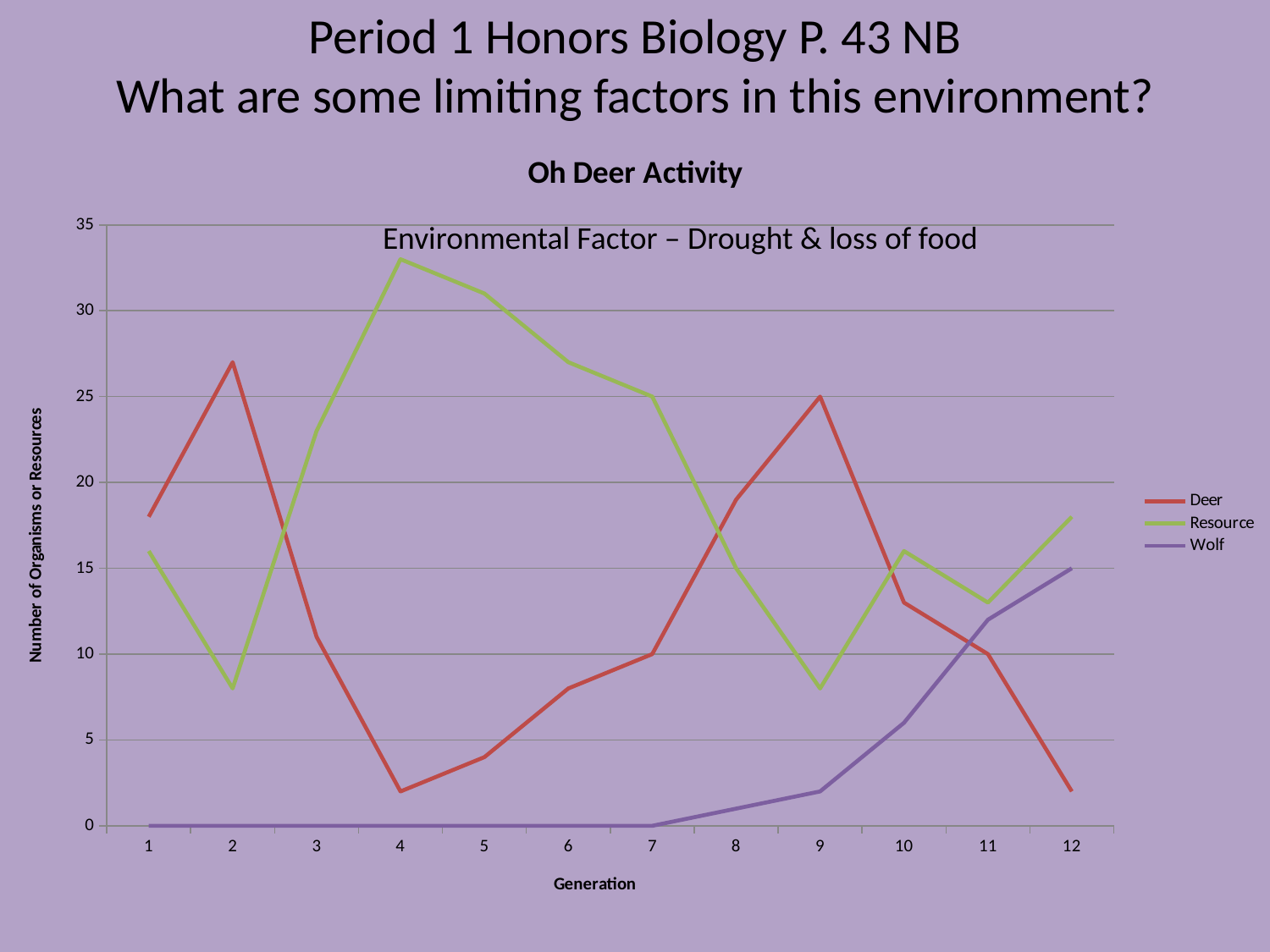
At which generation does the Resource series reach its highest value? 4 Is the Deer value at generation 4 greater or less than 5? less At which generation does the Deer series reach its highest value? 2 At generation 4, which is larger, the Deer value or the Resource value? Resource What is the Deer value at generation 9? 25 What is the Deer value at generation 7? 10 What is the Wolf value at generation 1? 0 What kind of chart is shown on the slide? Line chart Is the Resource value at generation 4 greater or less than 30? greater How many series does the legend list? 3 Does the Wolf series rise or fall from generation 7 to generation 12? Rise How many generations are plotted along the x axis? 12